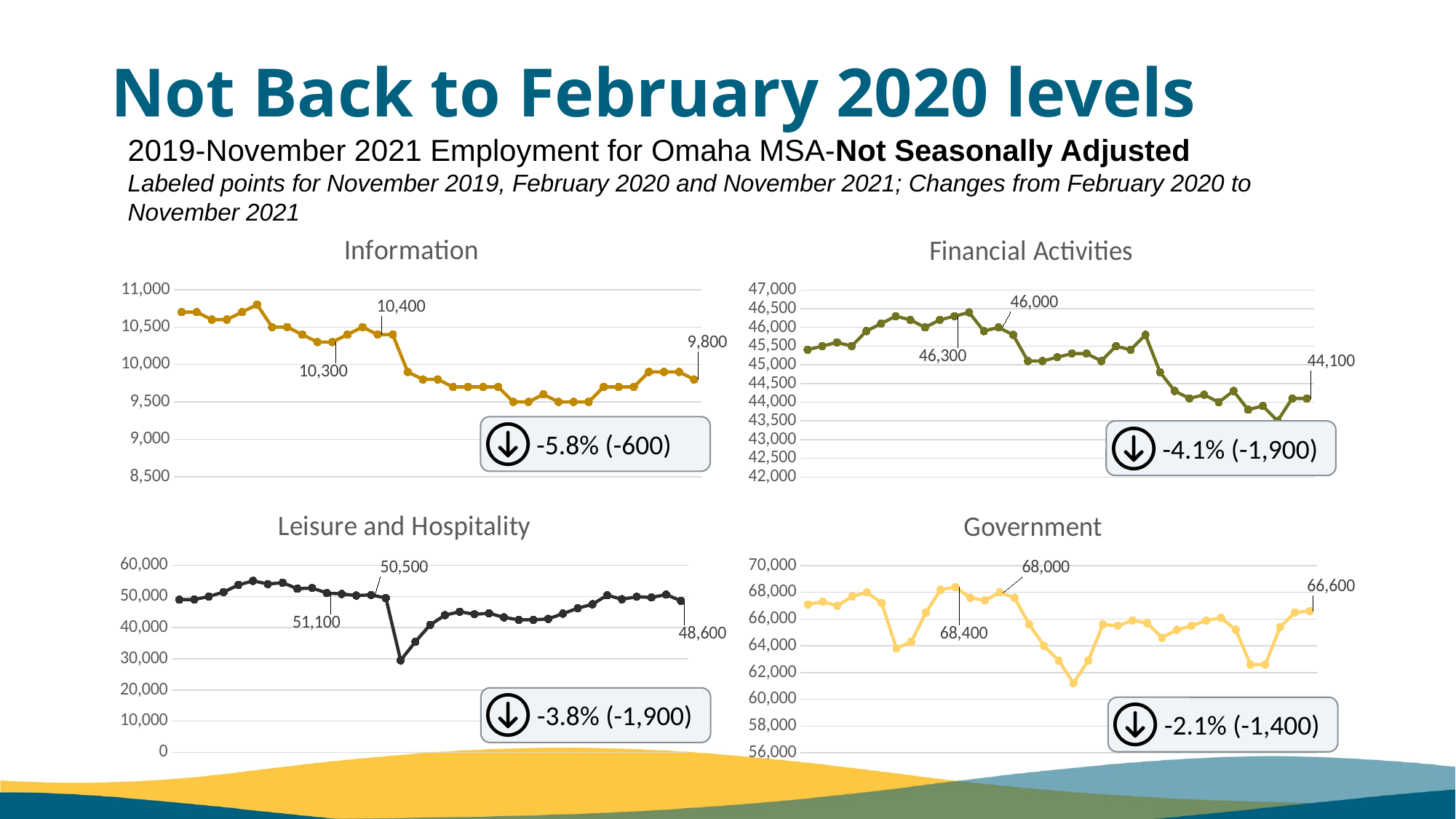
What kind of chart is the Information chart? Line chart What percentage change from February 2020 to November 2021 is shown in the callout on the Financial Activities chart? -4.1% (-1,900) In the Government chart, what is the labeled value for February 2020? 68,000 In the Financial Activities chart, which is larger, the November 2019 value or the February 2020 value? November 2019 In the Government chart, what is the difference between the February 2020 value and the November 2021 value? 1,400 In the Financial Activities chart, what is the labeled value for November 2019? 46,300 In the Information chart, what is the labeled value for November 2021? 9,800 In the Leisure and Hospitality chart, what is the labeled value for November 2021? 48,600 In the Information chart, what is the labeled value for February 2020? 10,400 In the Leisure and Hospitality chart, what is the difference between the November 2019 value and the February 2020 value? 600 In the Information chart, do the values overall rise or fall from the start to the end of the period? Fall